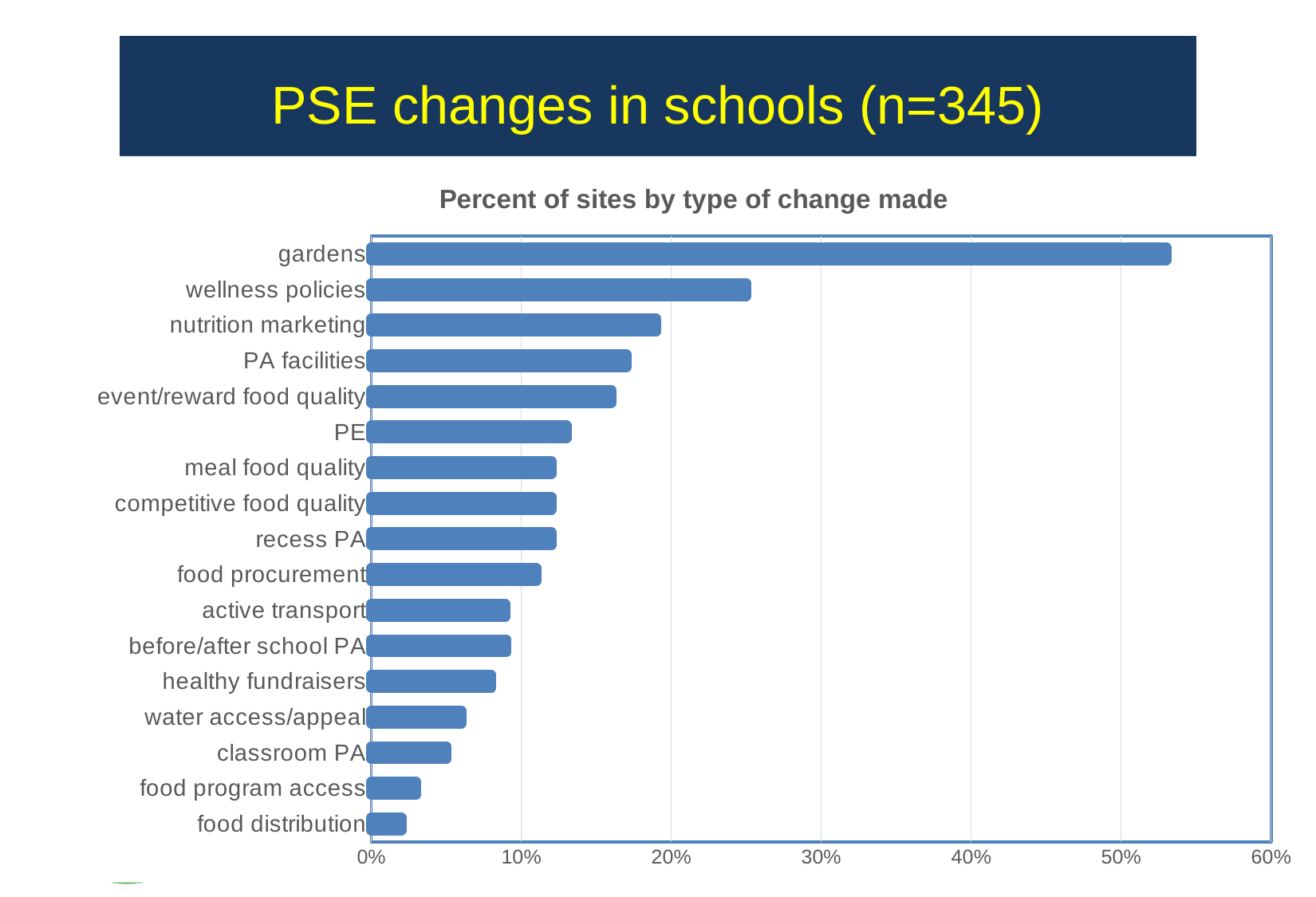
Is the value for classroom PA greater or less than 10%? less Which has a higher percent of sites, PE or water access/appeal? PE Which has a higher percent of sites, gardens or wellness policies? gardens What type of chart is shown on the slide? bar chart Which type of change has the lowest percent of sites? food distribution Which type of change has the highest percent of sites? gardens Is the value for wellness policies greater or less than 20%? greater Is the value for nutrition marketing greater or less than 20%? less How many types of change are listed on the chart? 17 What is the title of the chart? Percent of sites by type of change made